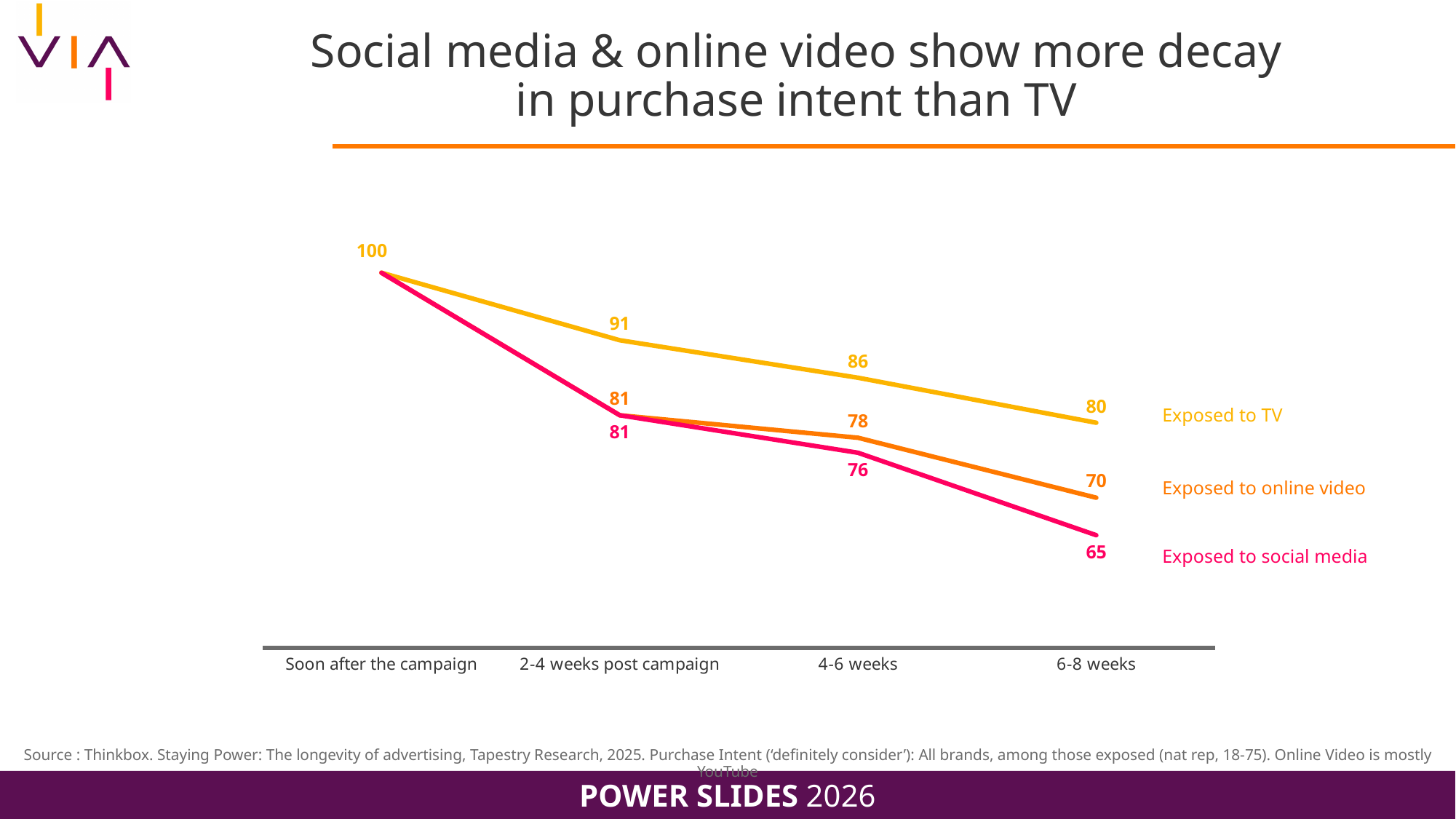
How many time points are shown on the x axis? 4 What is the difference between Exposed to TV and Exposed to social media at 6-8 weeks? 15 What kind of chart is shown on the slide? Line chart How many series are plotted on the chart? 3 What is the value for Exposed to TV at 6-8 weeks? 80 What is the difference between Exposed to online video and Exposed to social media at 4-6 weeks? 2 What is the value for Exposed to online video at 2-4 weeks post campaign? 81 Which is larger at 2-4 weeks post campaign: Exposed to TV or Exposed to online video? Exposed to TV Which series has the highest value at 4-6 weeks? Exposed to TV Do the values for Exposed to social media rise or fall from Soon after the campaign to 6-8 weeks? Fall What is the value for Exposed to social media at 4-6 weeks? 76 Which series has the lowest value at 6-8 weeks? Exposed to social media